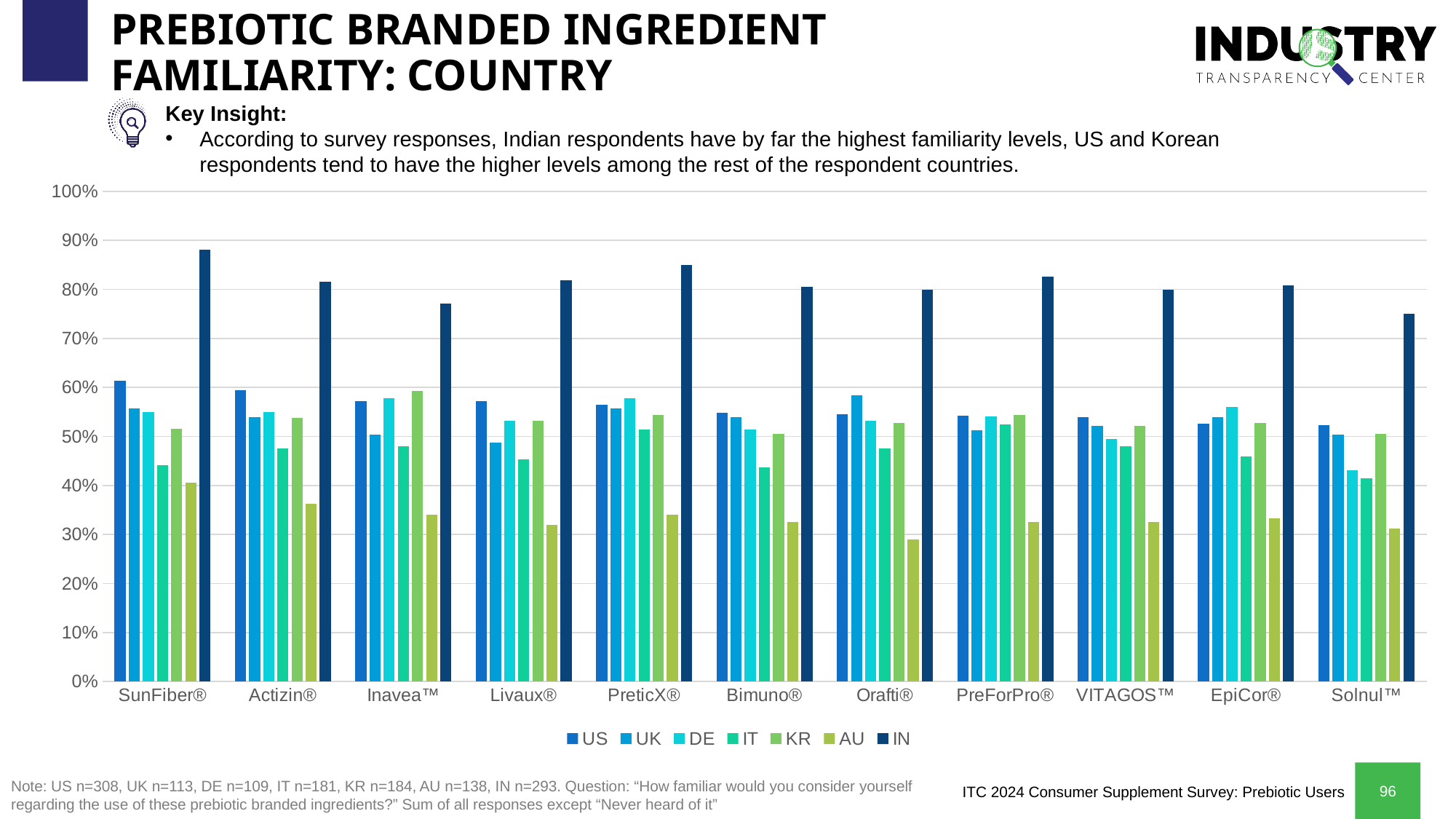
Is the KR value for Inavea™ greater or less than 50%? greater Which country has the highest familiarity level for SunFiber®? IN For Inavea™, which is larger: the KR value or the IT value? KR For which ingredient is the IN value the highest? SunFiber® Which country has the lowest familiarity level for SunFiber®? AU Is the IN value for Solnul™ greater or less than 80%? less What kind of chart is shown on the slide? bar chart Is the IT value for Bimuno® greater or less than 50%? less For which ingredient is the AU value the lowest? Orafti® Which series is shown in the darkest navy colour in the legend? IN How many series does the legend list? 7 How many branded ingredients are shown along the x axis? 11